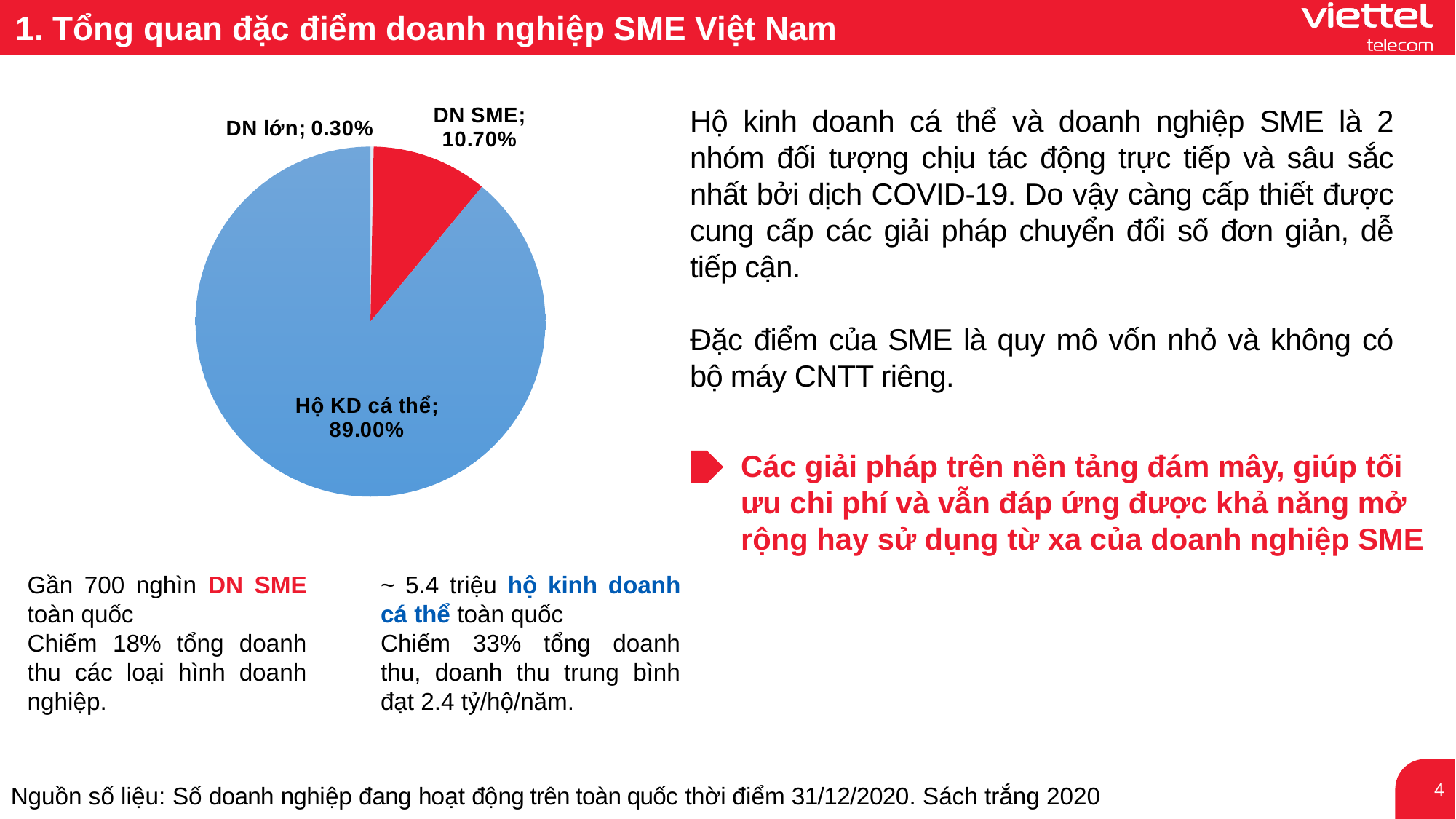
What is the difference in percentage points between "Hộ KD cá thể" and "DN SME"? 78.30% Which is larger, the share for "DN SME" or the share for "DN lớn"? DN SME What share of the pie does "DN lớn" hold? 0.30% What share of the pie does "Hộ KD cá thể" hold? 89.00% Which category has the largest slice of the pie? Hộ KD cá thể How many slices does the pie chart have? 3 What share of the pie does "DN SME" hold? 10.70% What is the difference in percentage points between "DN SME" and "DN lớn"? 10.40% What colour is the "Hộ KD cá thể" slice of the pie? blue Which category has the smallest slice of the pie? DN lớn What colour is the "DN SME" slice of the pie? red What kind of chart is shown on the slide? pie chart